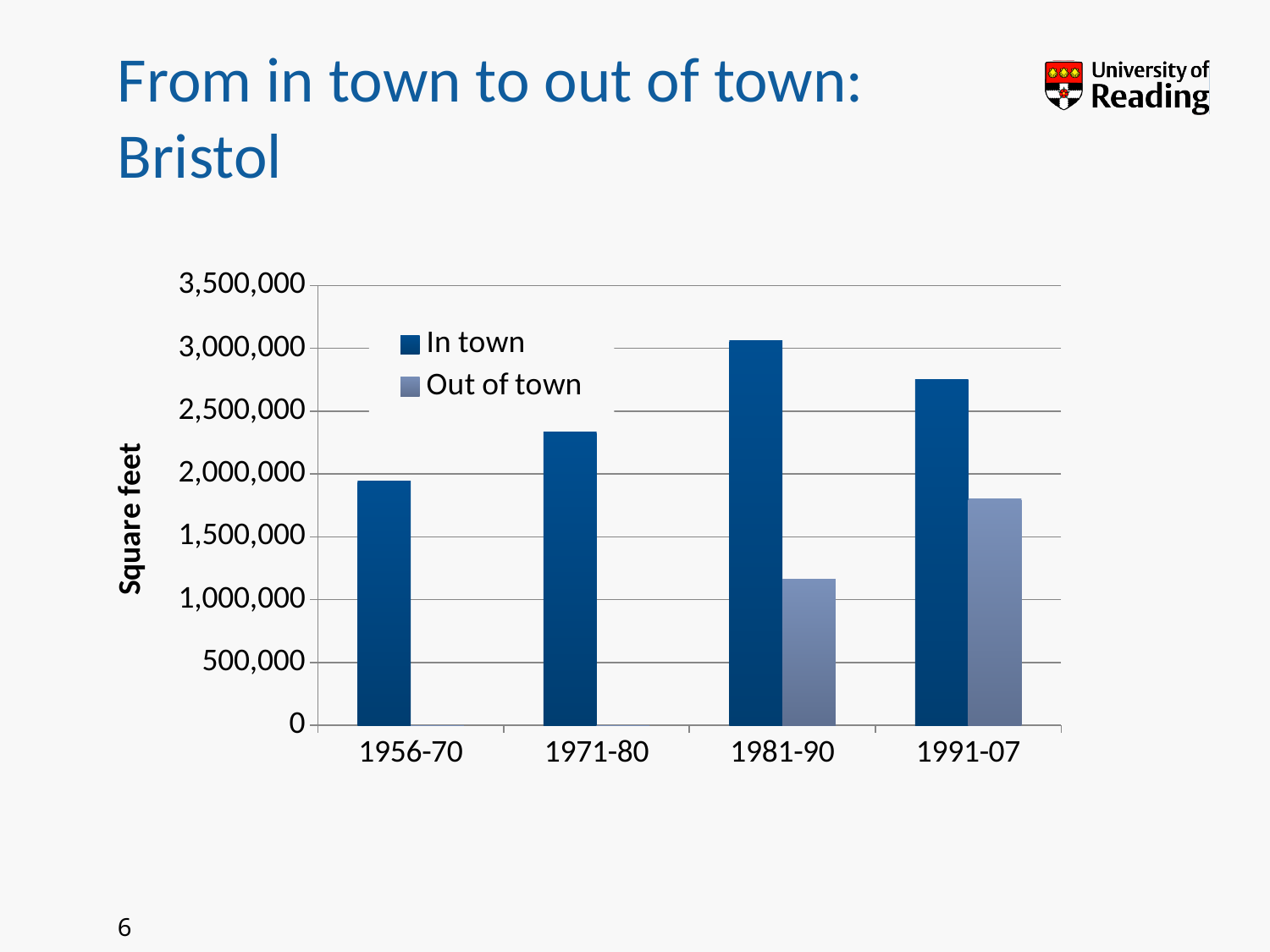
Is the In town value for 1981-90 greater or less than 3,000,000? greater What kind of chart is shown on the slide? Bar chart How many series does the legend list? 2 How many time periods are shown on the x axis? 4 Is the Out of town value for 1981-90 greater or less than 1,500,000? less What is the label on the vertical axis? Square feet Does the Out of town value rise or fall from 1981-90 to 1991-07? rise Which period has the lowest In town value? 1956-70 Which is larger for 1991-07, the In town value or the Out of town value? In town Which period has the highest In town value? 1981-90 Which period has the highest Out of town value? 1991-07 Is the In town value for 1956-70 greater or less than 2,000,000? less